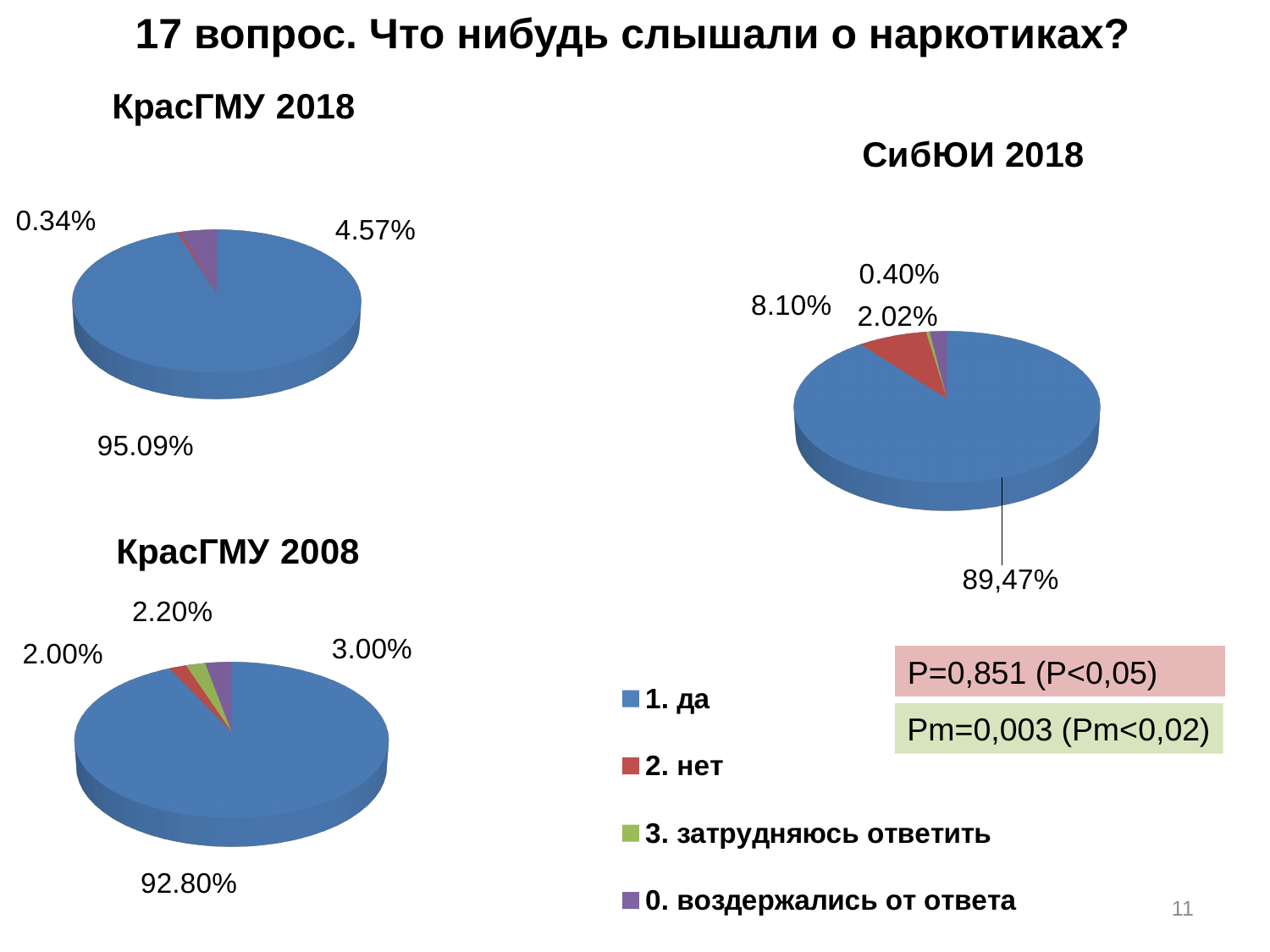
On the КрасГМУ 2008 chart, what share of respondents answered "2. нет"? 2.00% On the КрасГМУ 2018 chart, what share of respondents answered "1. да"? 95.09% Which answer has the smallest slice on the КрасГМУ 2008 chart? 2. нет How many entries does the legend list? 4 What is the difference between the "1. да" shares on the КрасГМУ 2018 and КрасГМУ 2008 charts? 2.29% On the СибЮИ 2018 chart, what share of respondents answered "1. да"? 89,47% On the СибЮИ 2018 chart, what share of respondents answered "2. нет"? 8.10% On the КрасГМУ 2008 chart, what share of respondents answered "0. воздержались от ответа"? 3.00% On the КрасГМУ 2008 chart, what share of respondents answered "3. затрудняюсь ответить"? 2.20% On the КрасГМУ 2008 chart, what share of respondents answered "1. да"? 92.80% What type of chart is used on this slide? Pie chart Which answer has the largest slice on the СибЮИ 2018 chart? 1. да